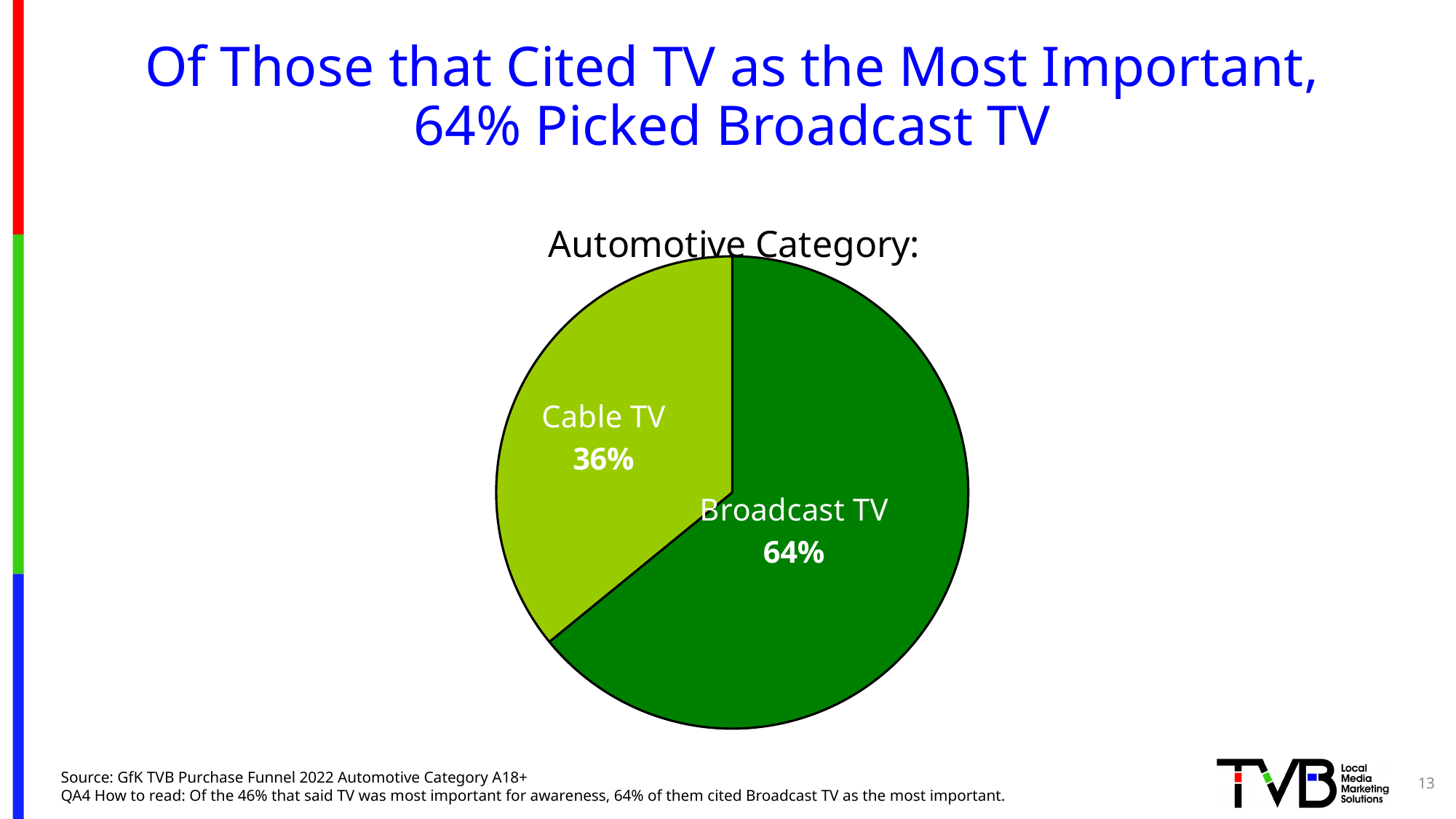
Which is larger, the Cable TV slice or the Broadcast TV slice? Broadcast TV What kind of chart is shown on the slide? Pie chart What is the difference in percentage points between the Broadcast TV and Cable TV slices? 28 What share of the pie is Cable TV? 36% How many slices does the pie chart have? 2 Which slice is shown in the darker green colour? Broadcast TV What share of the pie is Broadcast TV? 64% What is the title of the chart? Automotive Category: Is the value for Cable TV greater or less than 50%? less Which slice of the pie is the smallest? Cable TV Which slice of the pie is the largest? Broadcast TV